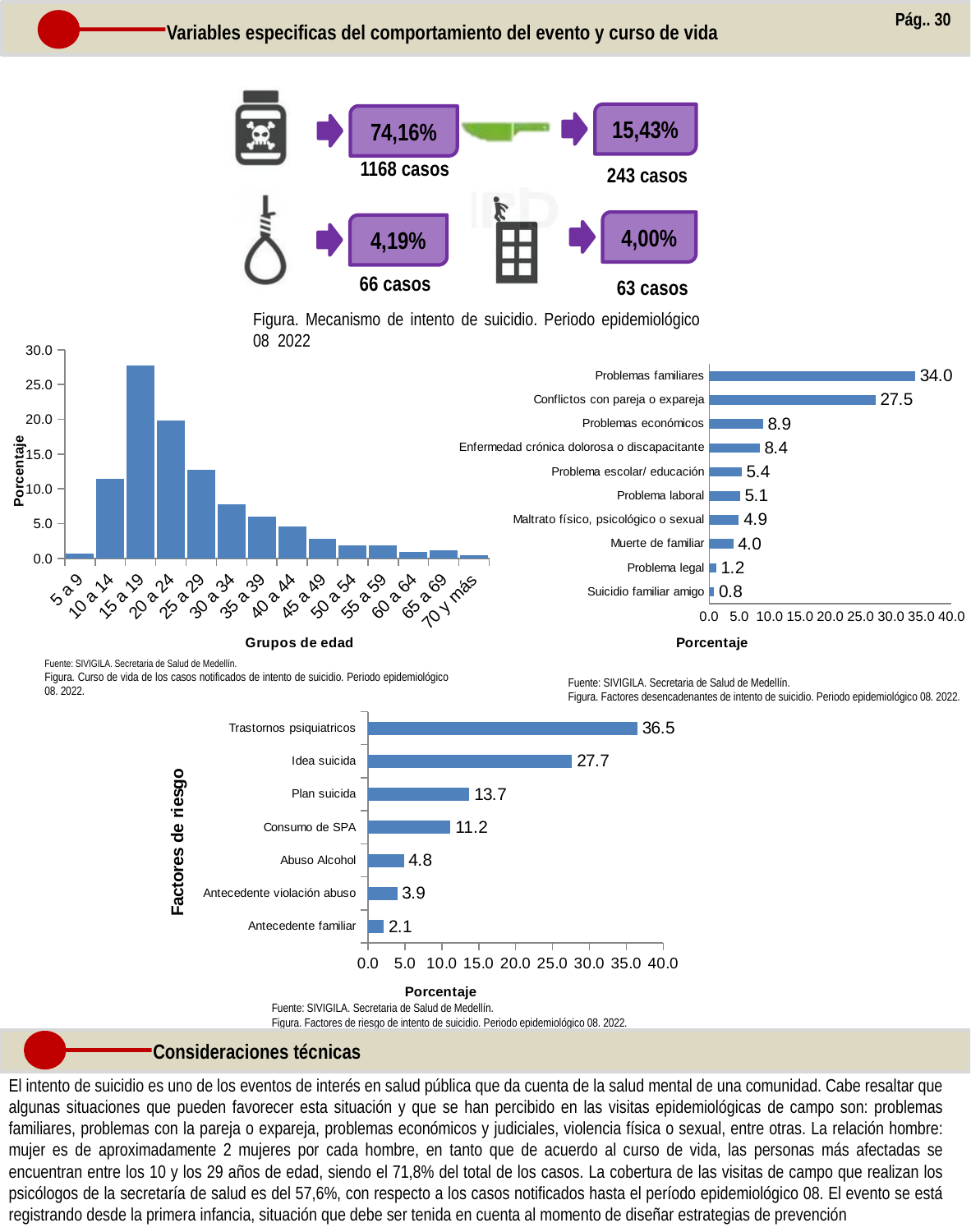
In the Grupos de edad chart (left, middle of the slide), which age group has the highest percentage? 15 a 19 In the chart of factores de riesgo (bottom of the slide), which is larger: Plan suicida or Abuso Alcohol? Plan suicida In the chart of factores de riesgo (bottom of the slide), what is the value for Trastornos psiquiatricos? 36.5 In the chart of factores desencadenantes (right, middle of the slide), what is the difference between Problemas familiares and Conflictos con pareja o expareja? 6.5 In the chart of factores de riesgo (bottom of the slide), what is the value for Consumo de SPA? 11.2 In the chart of factores desencadenantes (right, middle of the slide), what is the value for Problemas familiares? 34.0 In the chart of factores desencadenantes (right, middle of the slide), what is the value for Conflictos con pareja o expareja? 27.5 In the chart of factores de riesgo (bottom of the slide), what is the difference between Trastornos psiquiatricos and Idea suicida? 8.8 In the chart of factores desencadenantes (right, middle of the slide), how many categories are shown? 10 In the chart of factores de riesgo (bottom of the slide), how many risk factors are listed? 7 In the chart of factores desencadenantes (right, middle of the slide), which category has the lowest value? Suicidio familiar amigo In the Grupos de edad chart (left, middle of the slide), is the value for 15 a 19 greater or less than 25.0? greater